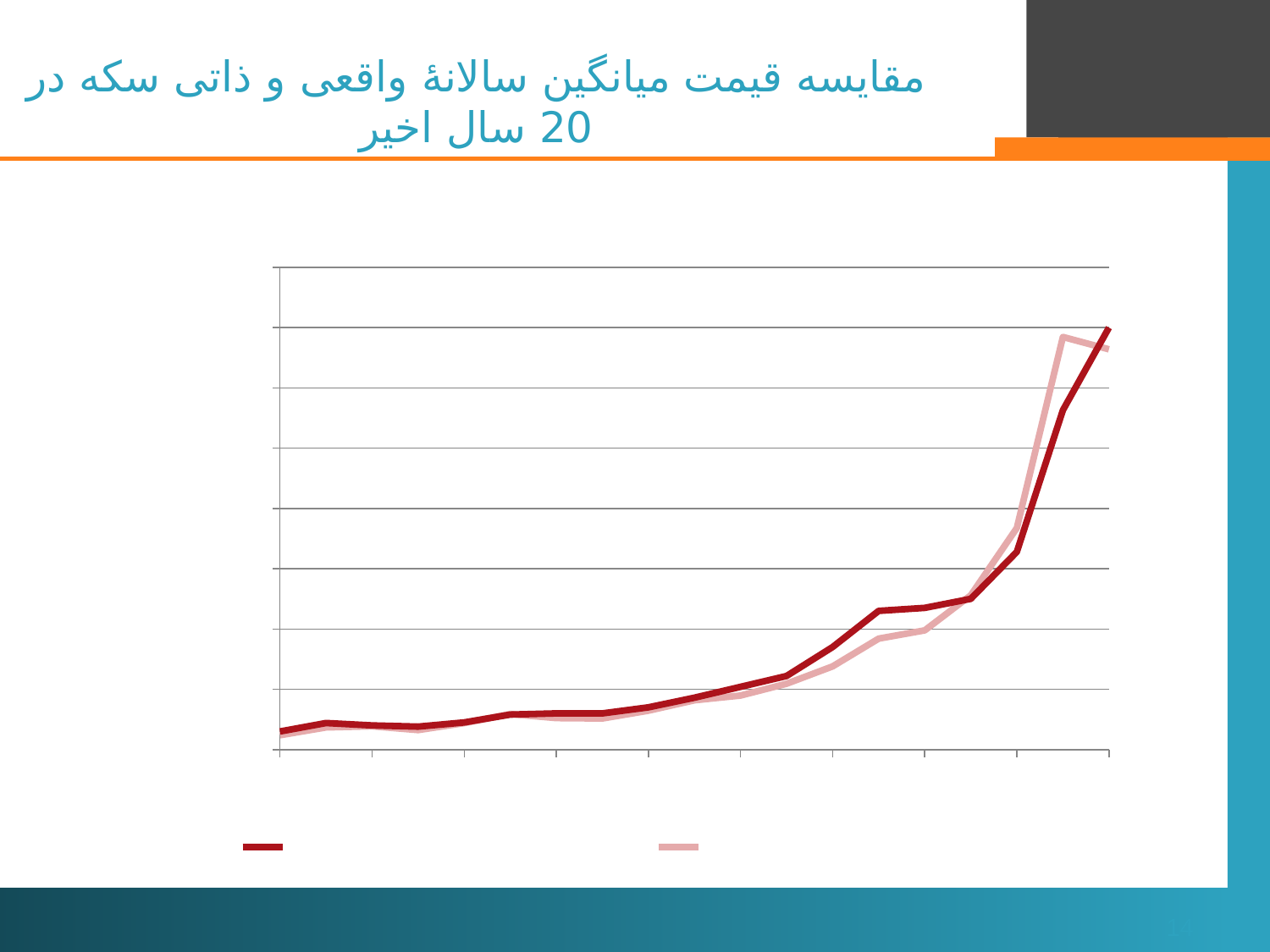
At the second-to-last point, which line is higher, the dark red line or the light pink line? light pink line What is the title of the slide? مقایسه قیمت میانگین سالانۀ واقعی و ذاتی سکه در 20 سال اخیر Do the values of the light pink line generally rise or fall from left to right along the x axis? rise What kind of chart is shown on the slide? line chart Do the values of the dark red line generally rise or fall from left to right along the x axis? rise What two colours are used for the lines in the chart? dark red and light pink At the last point on the right, which line is higher, the dark red line or the light pink line? dark red line How many series does the legend show? 2